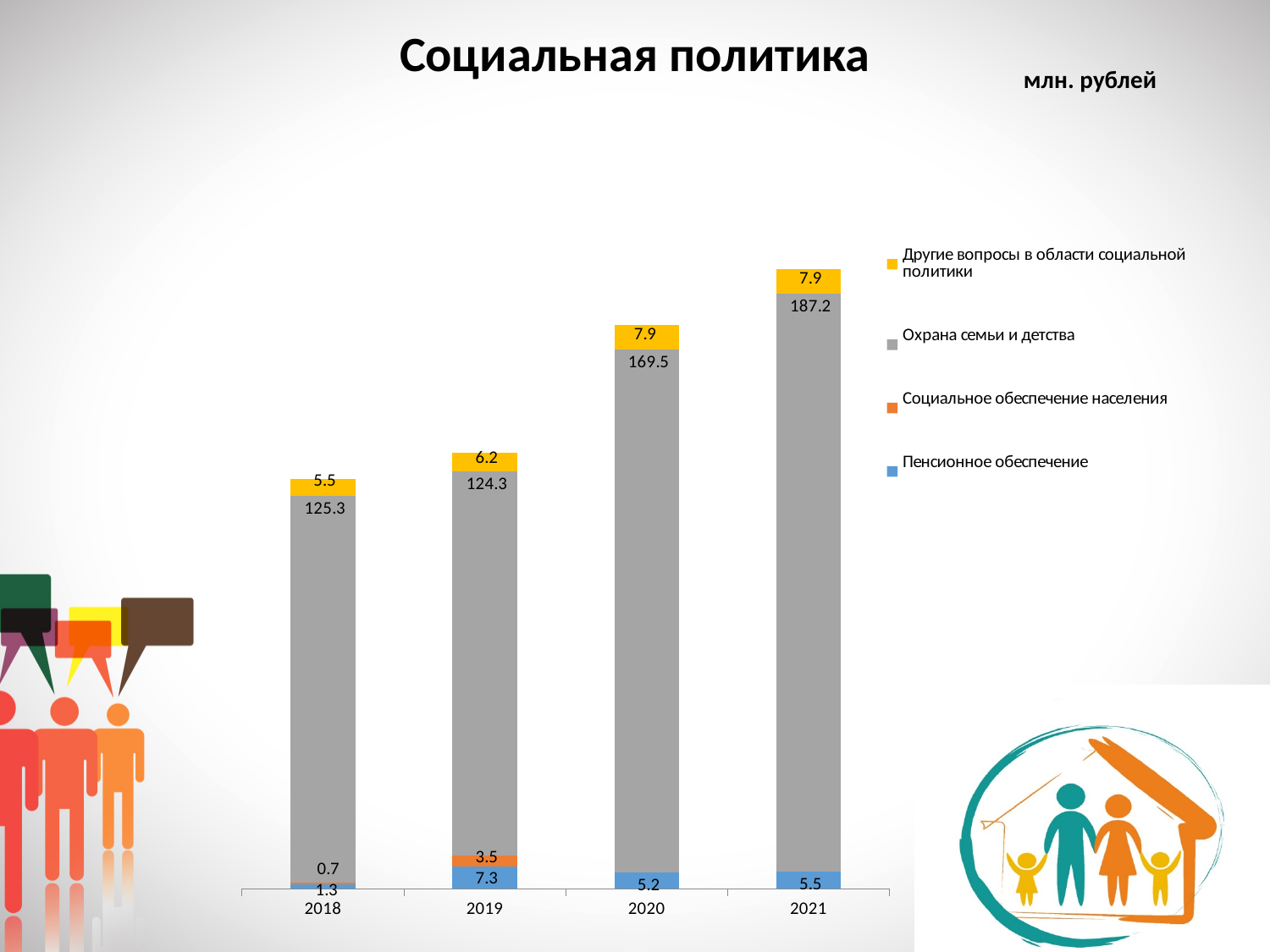
What is the value for Другие вопросы в области социальной политики in 2018? 5.5 What is the value for Социальное обеспечение населения in 2019? 3.5 What is the value for Охрана семьи и детства in 2021? 187.2 What is the difference between the Охрана семьи и детства values for 2021 and 2020? 17.7 What is the value for Пенсионное обеспечение in 2019? 7.3 In which year is the value for Пенсионное обеспечение lowest? 2018 What is the total of the stacked bar for 2018? 132.8 How many series does the legend list? 4 Which is larger: the Охрана семьи и детства value for 2018 or for 2019? 2018 How many years are shown on the x axis? 4 In which year is the value for Охрана семьи и детства highest? 2021 What kind of chart is shown on the slide? stacked bar chart